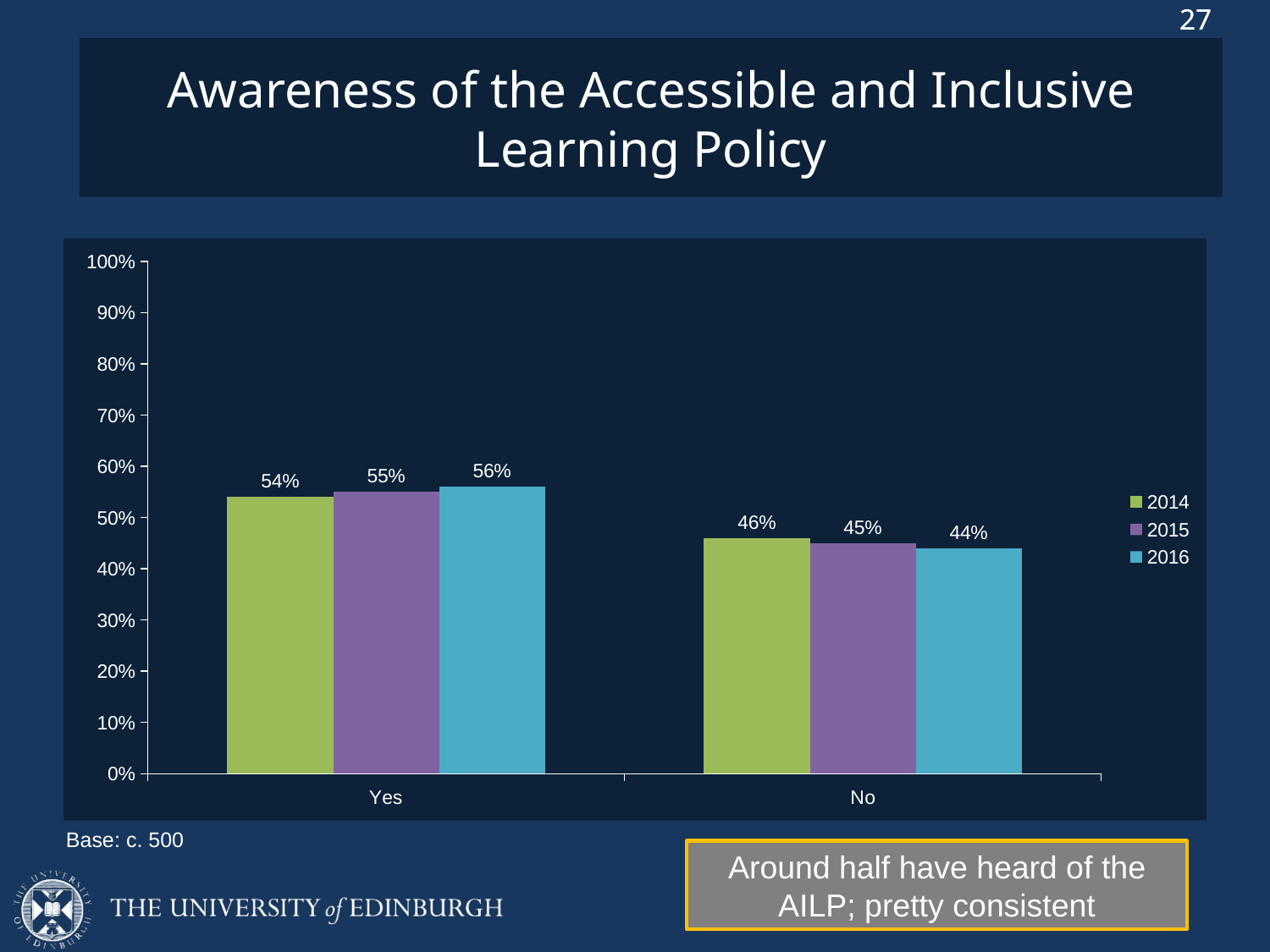
What is the value for 2016 in the Yes category? 56% How many series does the legend list? 3 What is the value for 2015 in the Yes category? 55% What is the difference between the 2014 values for Yes and No? 8% What is the value for 2014 in the No category? 46% Which is larger: the 2016 value for Yes or the 2016 value for No? Yes What kind of chart is shown on the slide? Bar chart Do the values for the Yes category rise or fall from 2014 to 2016? Rise What is the title of the slide containing the chart? Awareness of the Accessible and Inclusive Learning Policy Which year has the lowest value in the No category? 2016 Which year has the highest value in the Yes category? 2016 How many categories are shown on the x axis? 2